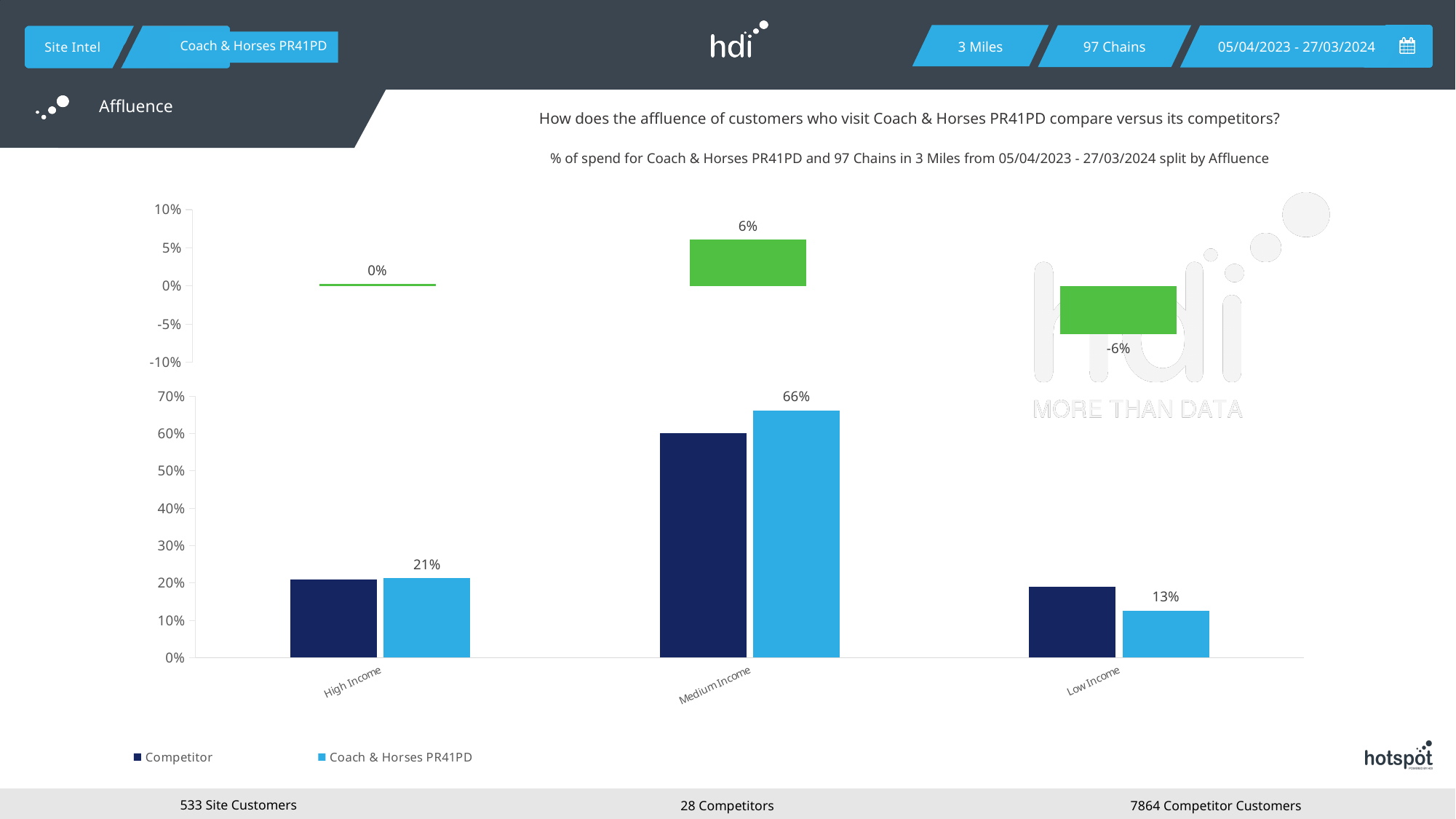
In the bottom bar chart, which is larger in the Low Income category: Competitor or Coach & Horses PR41PD? Competitor In the bottom bar chart, which category has the highest value for Coach & Horses PR41PD? Medium Income In the bottom bar chart, what is the value for Coach & Horses PR41PD in the Medium Income category? 66% In the bottom bar chart, what is the difference between the Coach & Horses PR41PD values for Medium Income and Low Income? 53% How many series does the legend of the bottom bar chart list? 2 In the bottom bar chart, is the Competitor value for Medium Income greater or less than 50%? greater In the top difference chart, what is the value shown for High Income? 0% In the bottom bar chart, what is the value for Coach & Horses PR41PD in the Low Income category? 13% In the top difference chart, what is the value shown for Medium Income? 6% In the top difference chart, what is the value shown for Low Income? -6% In the bottom bar chart, what is the value for Coach & Horses PR41PD in the High Income category? 21% In the bottom bar chart, which category has the lowest value for Coach & Horses PR41PD? Low Income